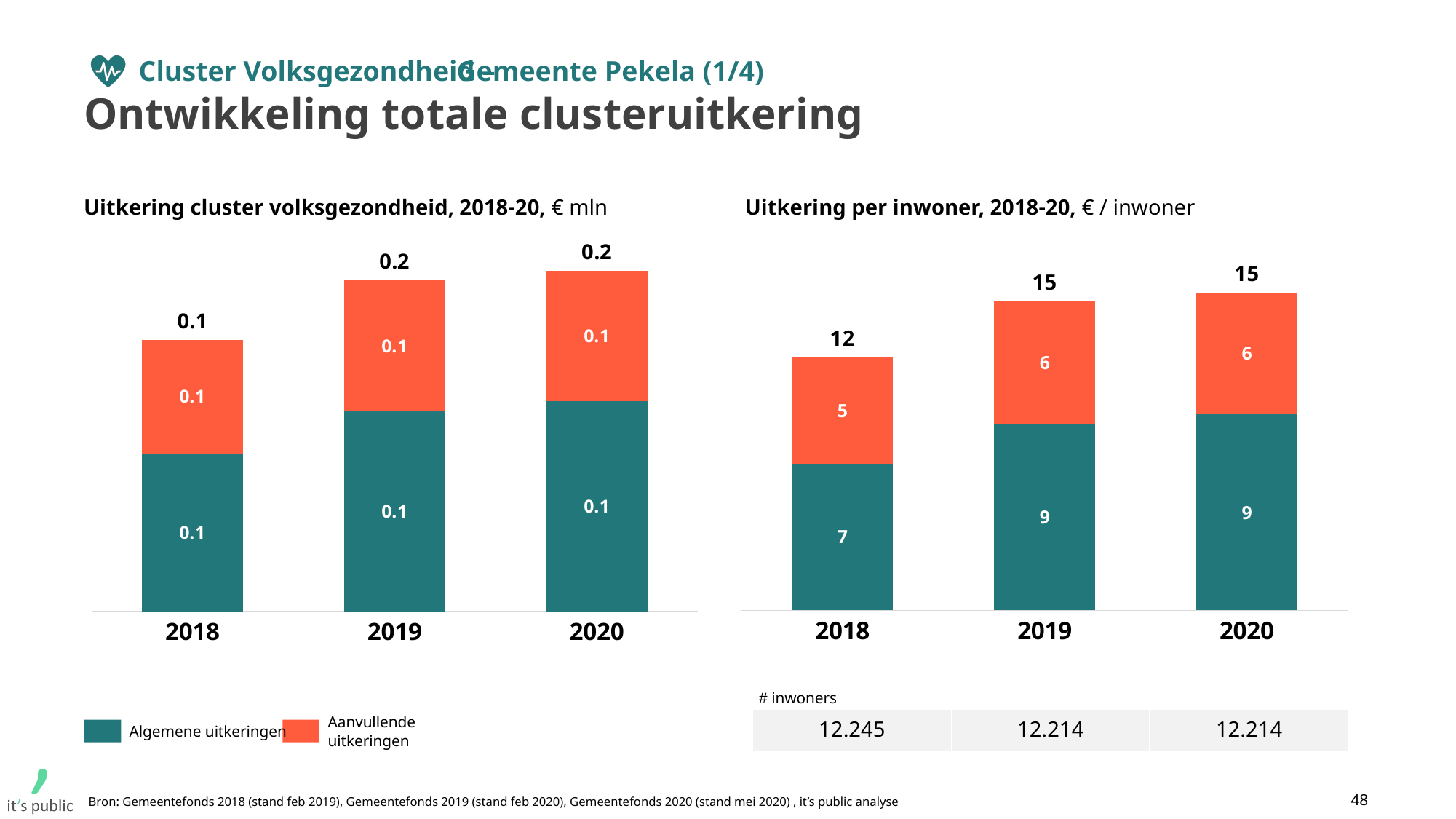
How many years are shown on the x axis of the 'Uitkering cluster volksgezondheid' chart? 3 In the 'Uitkering per inwoner' chart, what is the difference between the total for 2019 and the total for 2018? 3 In the 'Uitkering per inwoner' chart, what is the value of Algemene uitkeringen for 2019? 9 In the 'Uitkering cluster volksgezondheid' chart, what is the value of Aanvullende uitkeringen for 2019? 0.1 What kind of chart is the 'Uitkering per inwoner' chart? Stacked bar chart In the 'Uitkering cluster volksgezondheid' chart, what is the total value shown above the bar for 2020? 0.2 In the 'Uitkering per inwoner' chart, what is the value of Aanvullende uitkeringen for 2018? 5 Which series is shown in orange in the legend? Aanvullende uitkeringen How many series does the legend list for the charts on this slide? 2 In the 'Uitkering per inwoner' chart, what is the total value shown above the bar for 2018? 12 In the 'Uitkering per inwoner' chart, which year has the lowest total value? 2018 In the 'Uitkering per inwoner' chart, is the Algemene uitkeringen value for 2020 larger or smaller than the Aanvullende uitkeringen value for 2020? larger